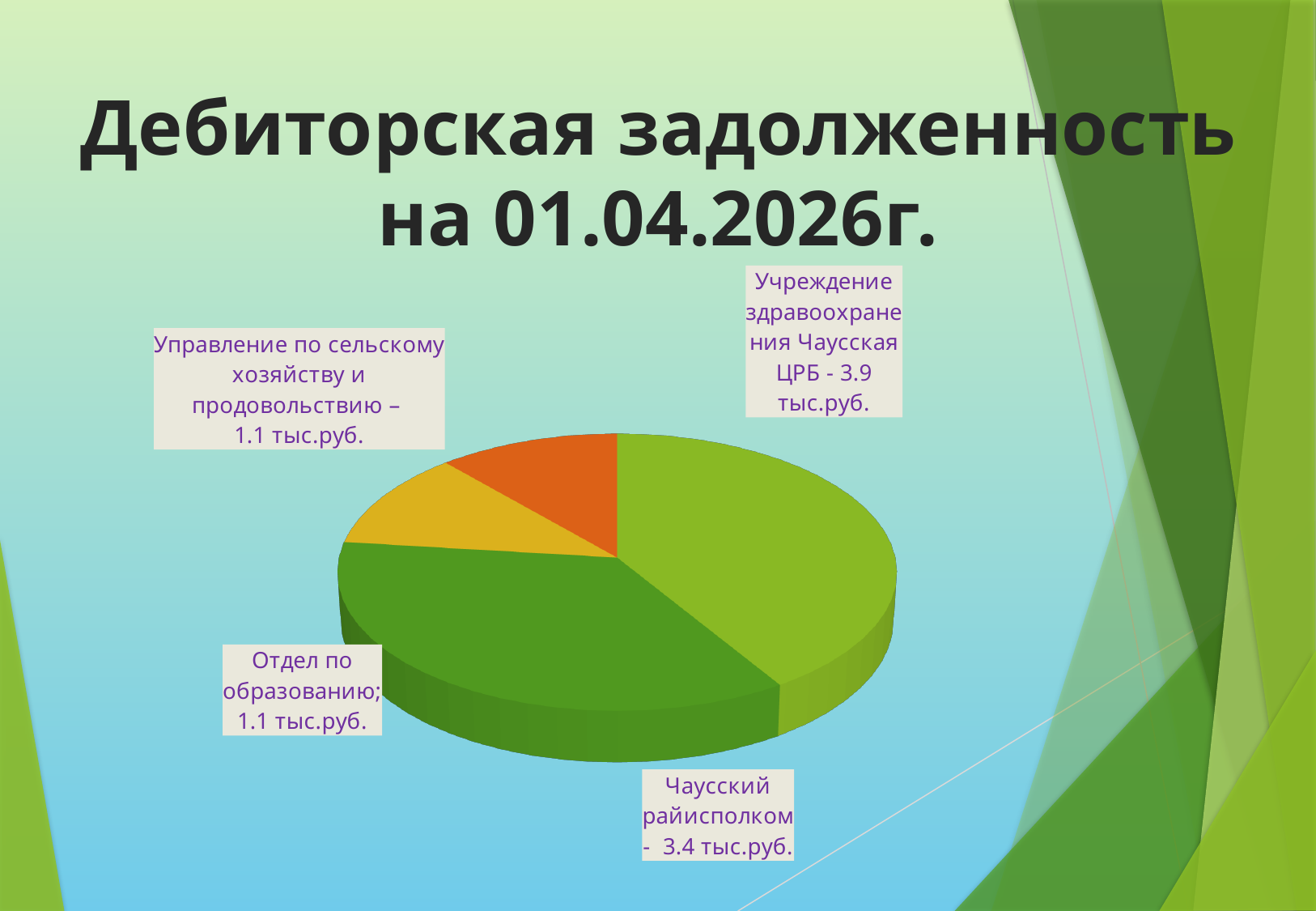
What is the value for Учреждение здравоохранения Чаусская ЦРБ? 3.9 тыс.руб. What is the value for Чаусский райисполком? 3.4 тыс.руб. What is the difference between the values for Учреждение здравоохранения Чаусская ЦРБ and Чаусский райисполком? 0.5 тыс.руб. Which category has the largest slice of the pie? Учреждение здравоохранения Чаусская ЦРБ What kind of chart is shown on the slide? Pie chart How many slices does the pie chart have? 4 What colour is the slice for Учреждение здравоохранения Чаусская ЦРБ? Light green What is the value for Отдел по образованию? 1.1 тыс.руб. Which is larger: the value for Чаусский райисполком or the value for Отдел по образованию? Чаусский райисполком What is the total of all slices in the pie chart? 9.5 тыс.руб. What is the value for Управление по сельскому хозяйству и продовольствию? 1.1 тыс.руб. What is the title of the slide containing the chart? Дебиторская задолженность на 01.04.2026г.